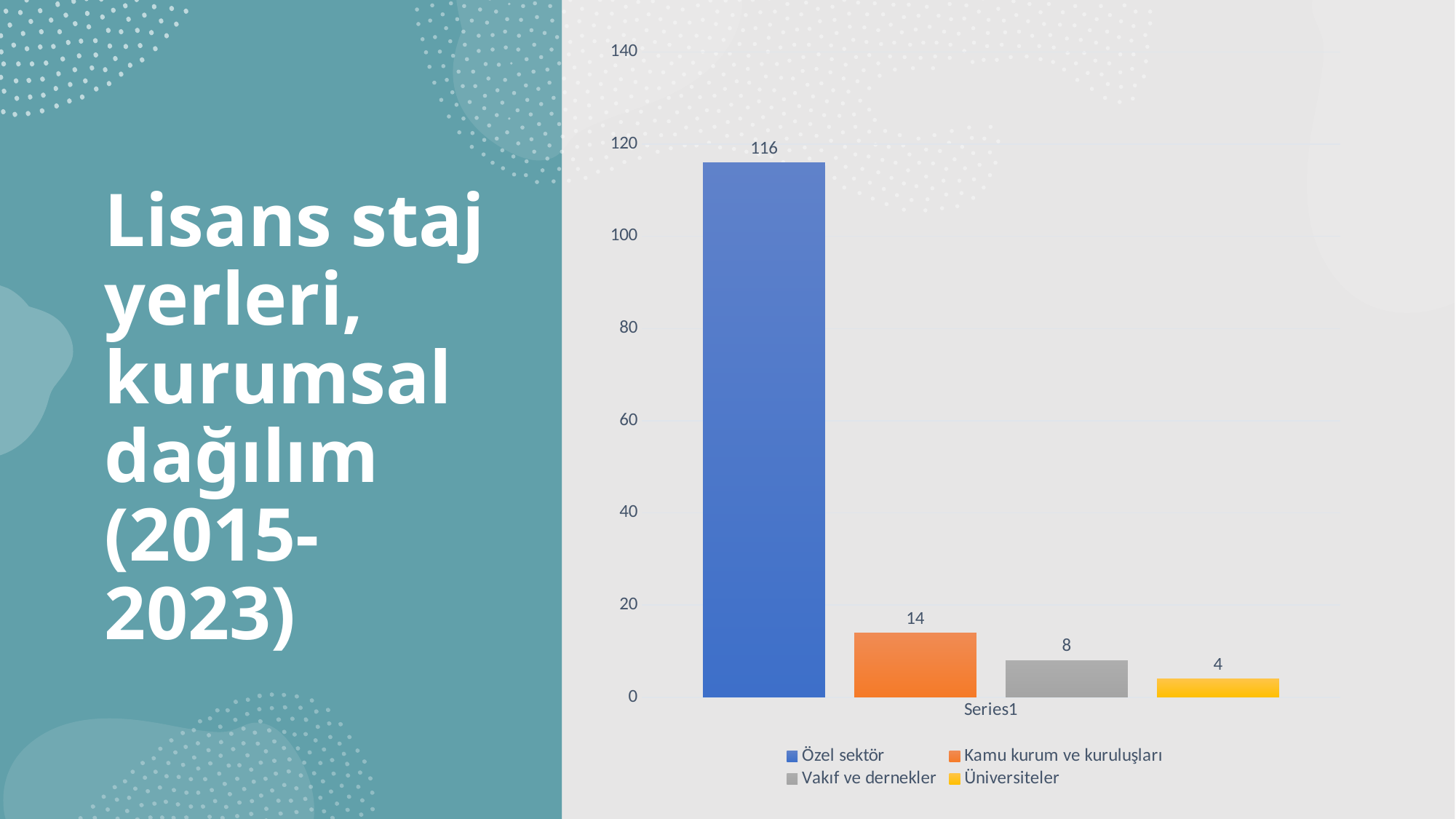
Which category has the highest value? Özel sektör What is the value for Özel sektör? 116 What kind of chart is shown on the slide? Bar chart What is the value for Üniversiteler? 4 Which category has the lowest value? Üniversiteler What is the value for Vakıf ve dernekler? 8 What colour is the bar for Üniversiteler? Yellow What is the difference between the values for Özel sektör and Kamu kurum ve kuruluşları? 102 What is the value for Kamu kurum ve kuruluşları? 14 How many series does the legend list? 4 Which is larger, the value for Kamu kurum ve kuruluşları or the value for Vakıf ve dernekler? Kamu kurum ve kuruluşları What is the difference between the values for Vakıf ve dernekler and Üniversiteler? 4